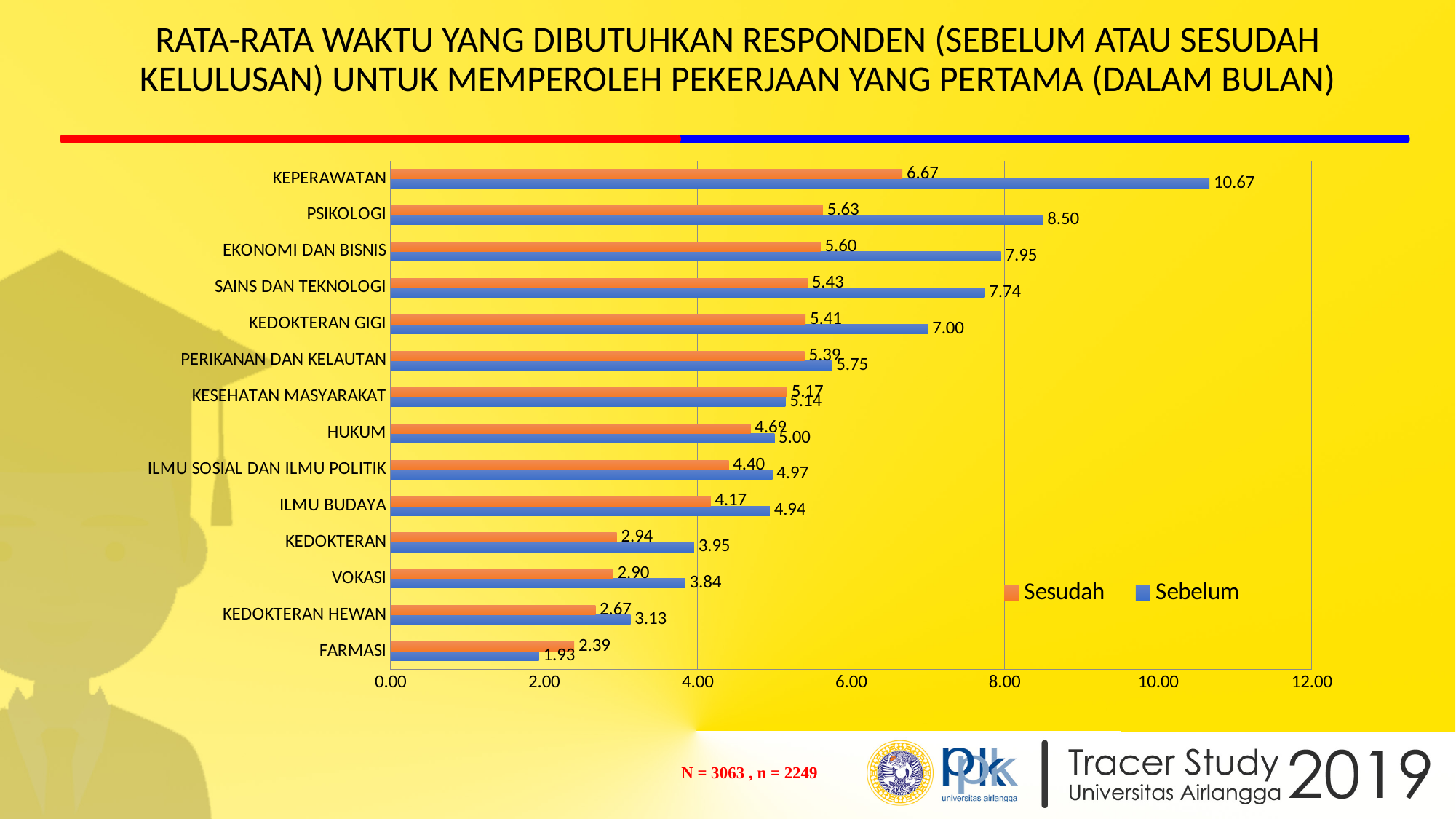
Which is larger for FARMASI, the Sebelum value or the Sesudah value? Sesudah Which category has the highest Sebelum value? KEPERAWATAN How many categories are shown on the chart? 14 Is the Sebelum value for EKONOMI DAN BISNIS greater or less than 8.00? less What is the Sebelum value for KEPERAWATAN? 10.67 What kind of chart is shown on the slide? bar chart What is the Sesudah value for FARMASI? 2.39 What is the Sebelum value for KEDOKTERAN GIGI? 7.00 Which category has the lowest Sebelum value? FARMASI How many series does the legend list? 2 Which colour represents the Sebelum series? blue What is the difference between the Sebelum and Sesudah values for PSIKOLOGI? 2.87